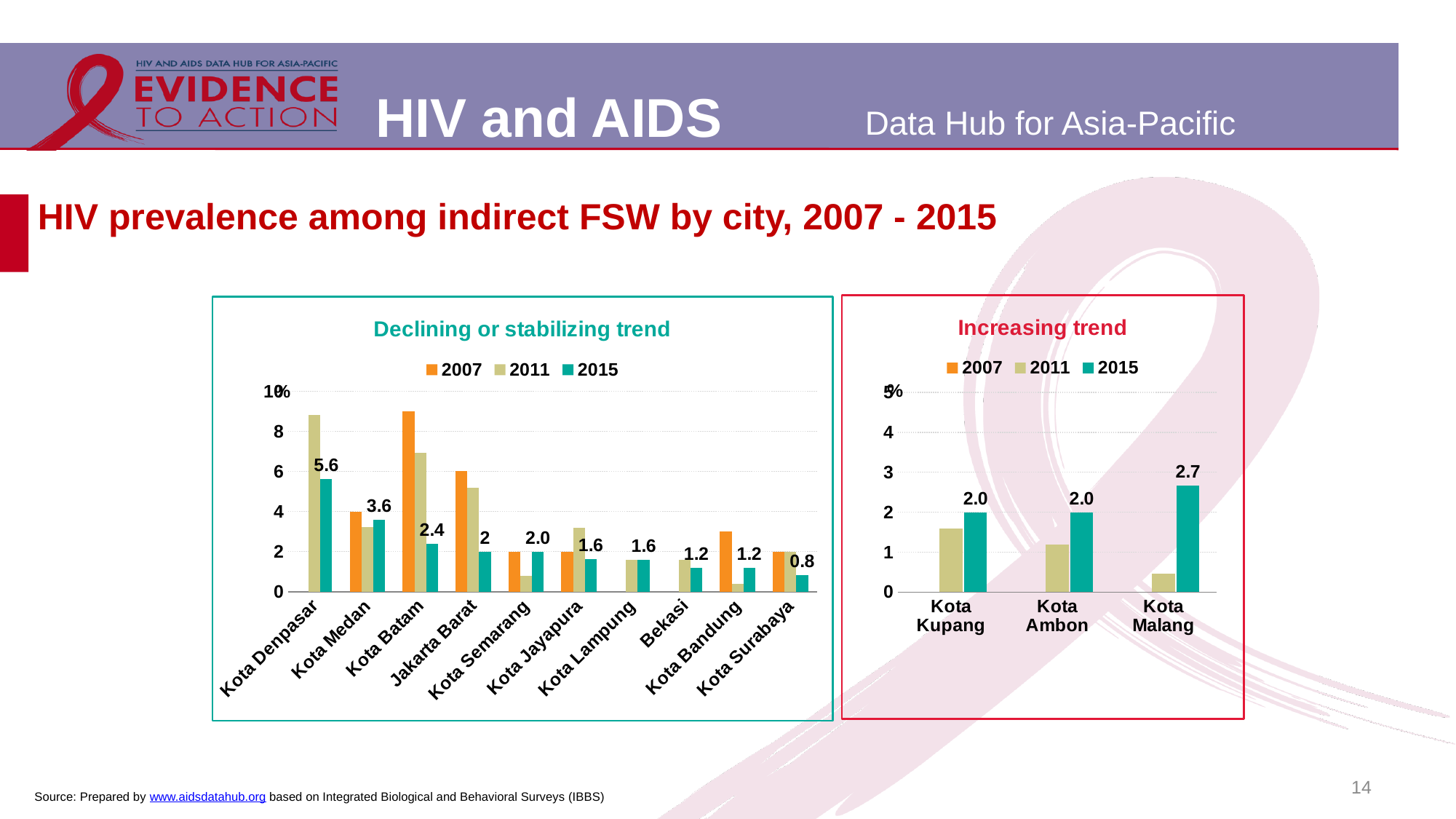
In the 'Declining or stabilizing trend' chart, is the 2011 value for Kota Denpasar greater or less than 8? greater In the 'Declining or stabilizing trend' chart, what is the difference between the 2015 values for Kota Denpasar and Kota Medan? 2 In the 'Increasing trend' chart, is the 2011 value for Kota Malang greater or less than 1? less How many series does the legend of the 'Increasing trend' chart list? 3 In the 'Increasing trend' chart, which city has the highest 2015 value? Kota Malang In the 'Declining or stabilizing trend' chart, what is the 2015 value for Kota Medan? 3.6 What type of chart is the 'Increasing trend' chart? Bar chart In the 'Declining or stabilizing trend' chart, which city has the lowest 2015 value? Kota Surabaya In the 'Declining or stabilizing trend' chart, which city has the highest 2015 value? Kota Denpasar In the 'Increasing trend' chart, what is the 2015 value for Kota Malang? 2.7 How many cities are shown in the 'Declining or stabilizing trend' chart? 10 In the 'Declining or stabilizing trend' chart, what is the 2015 value for Kota Denpasar? 5.6